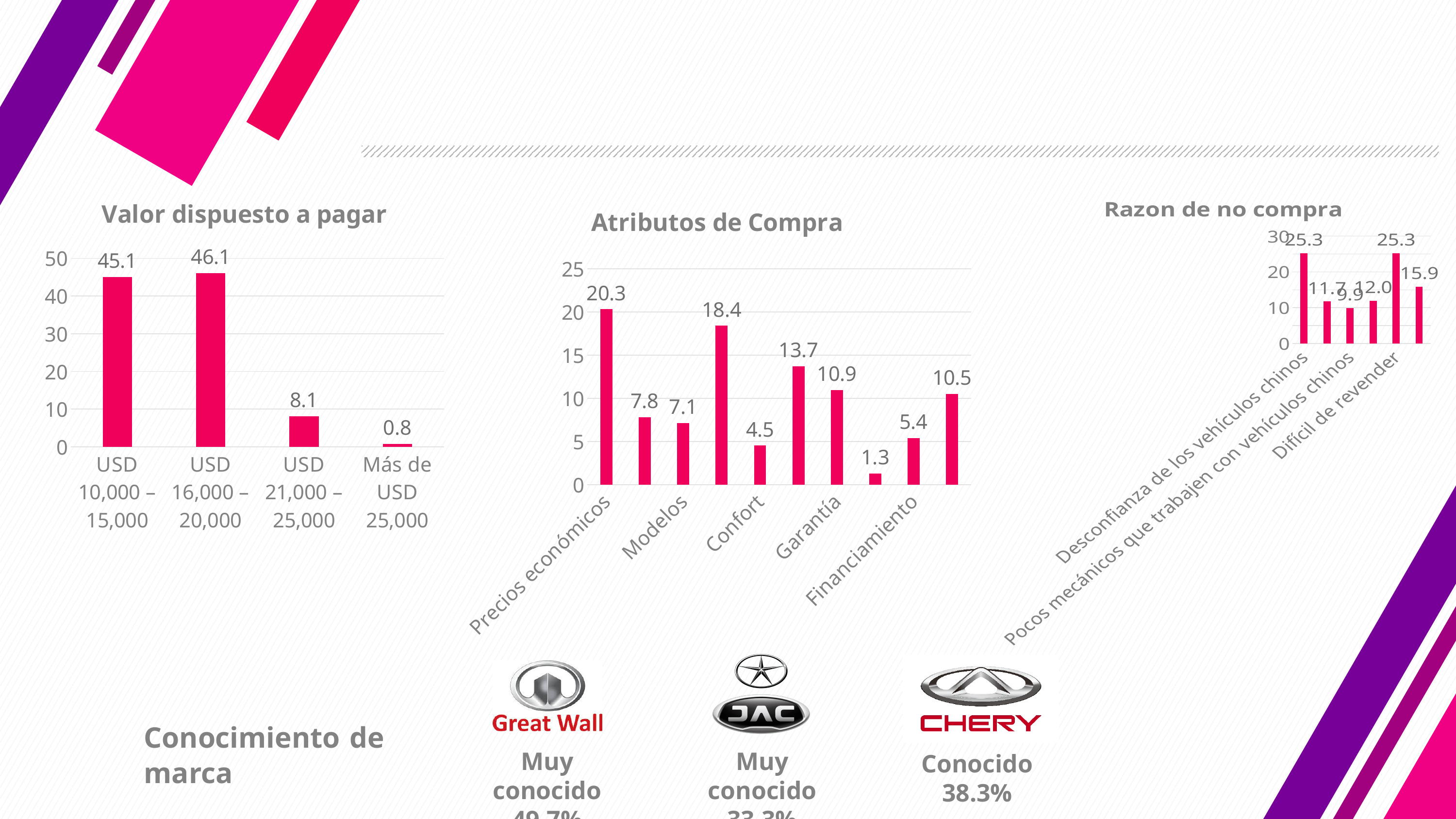
In the 'Valor dispuesto a pagar' chart, is the value for USD 21,000 – 25,000 greater or less than 10? less What kind of chart is 'Atributos de Compra'? bar chart In the 'Valor dispuesto a pagar' chart, what is the difference between the values for USD 10,000 – 15,000 and USD 21,000 – 25,000? 37.0 In the 'Razon de no compra' chart, how many bars are plotted? 6 In the 'Atributos de Compra' chart, what is the highest data label shown? 20.3 In the 'Atributos de Compra' chart, what is the lowest data label shown? 1.3 In the 'Valor dispuesto a pagar' chart, what is the value for USD 16,000 – 20,000? 46.1 In the 'Valor dispuesto a pagar' chart, which category has the lowest value? Más de USD 25,000 In the 'Razon de no compra' chart, what is the lowest data label shown? 9.9 In the 'Valor dispuesto a pagar' chart, how many categories are shown? 4 In the 'Atributos de Compra' chart, how many bars are plotted? 10 In the 'Valor dispuesto a pagar' chart, what is the value for Más de USD 25,000? 0.8